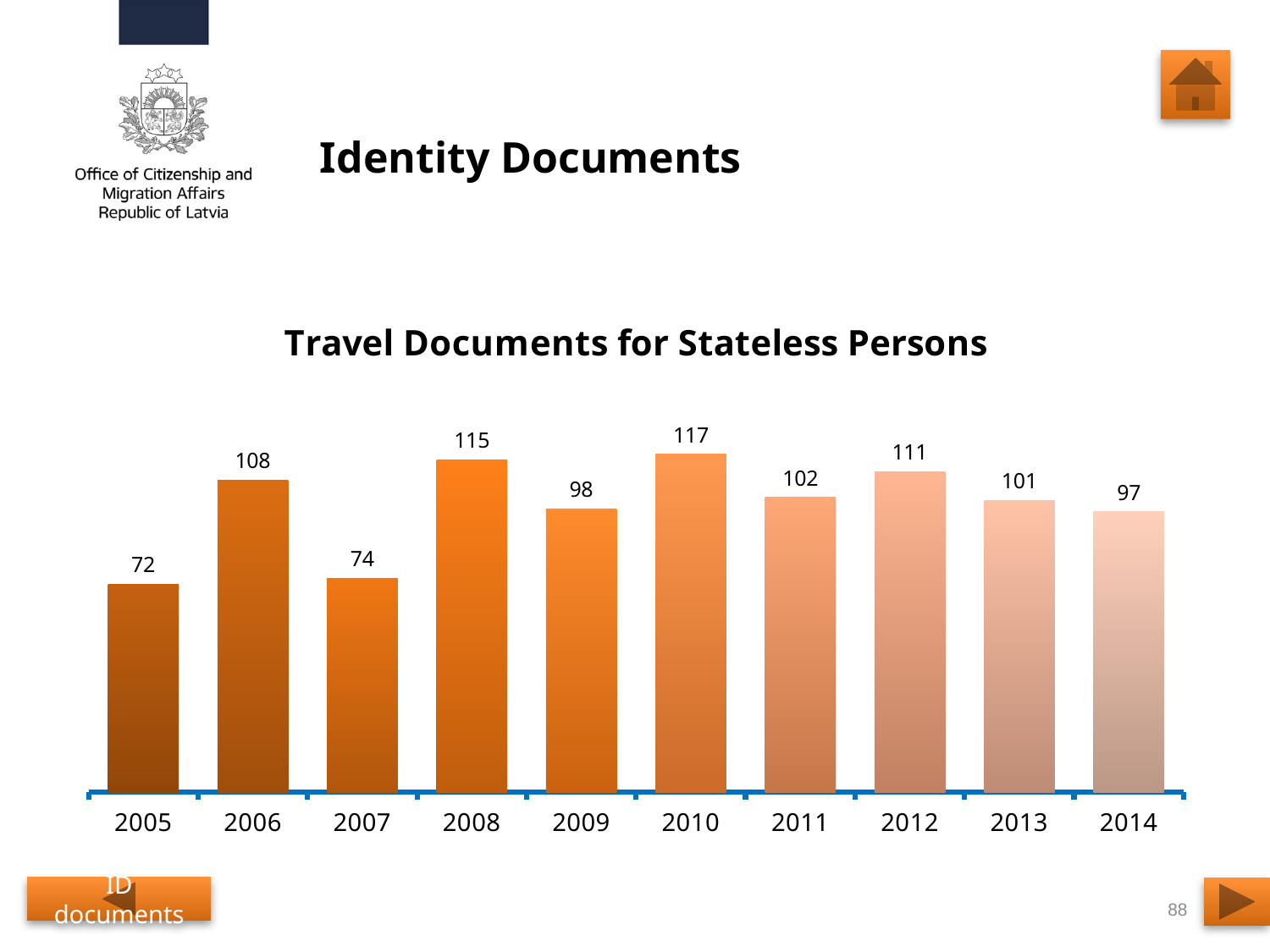
What is the value for 2014? 97 Which year has the lowest value? 2005 What is the difference between the values for 2008 and 2009? 17 What is the difference between the values for 2006 and 2007? 34 How many years are shown on the x axis? 10 What is the title of the chart? Travel Documents for Stateless Persons What is the value for 2005? 72 Which is larger, the value for 2012 or the value for 2013? 2012 What is the value for 2010? 117 What kind of chart is this? bar chart Which year has the highest value? 2010